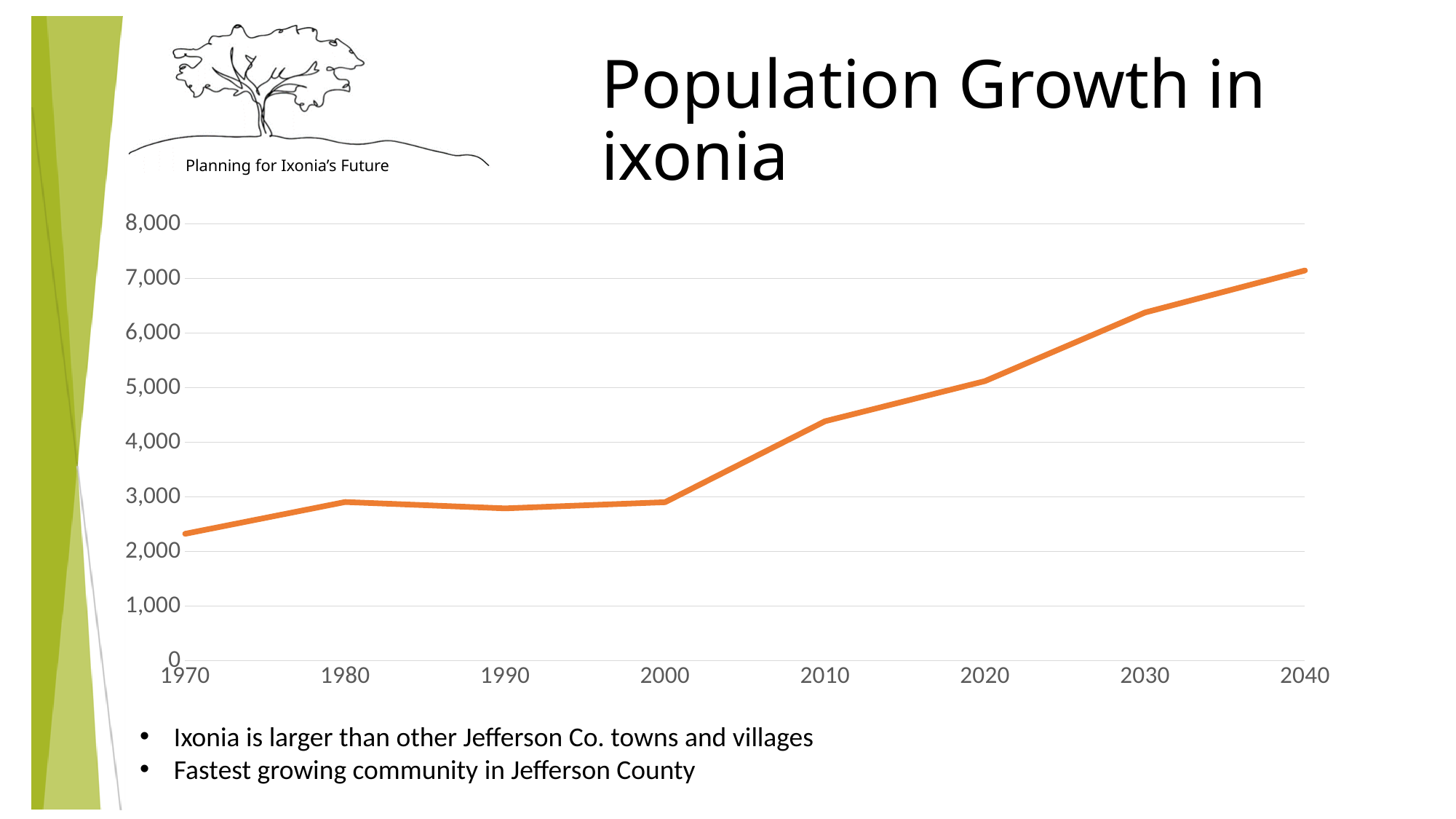
Is the population value for 2030 greater or less than 6,000? greater What kind of chart is shown on the slide? line chart Is the population value for 2010 greater or less than 4,000? greater Is the population value for 1970 greater or less than 3,000? less Which year has the larger population value, 2000 or 2010? 2010 How many years are plotted along the x axis of the chart? 8 What is the title of the chart on the slide? Population Growth in ixonia Which year has the lowest population value on the chart? 1970 Overall, does the population line rise or fall from 1970 to 2040? rise Which year has the highest population value on the chart? 2040